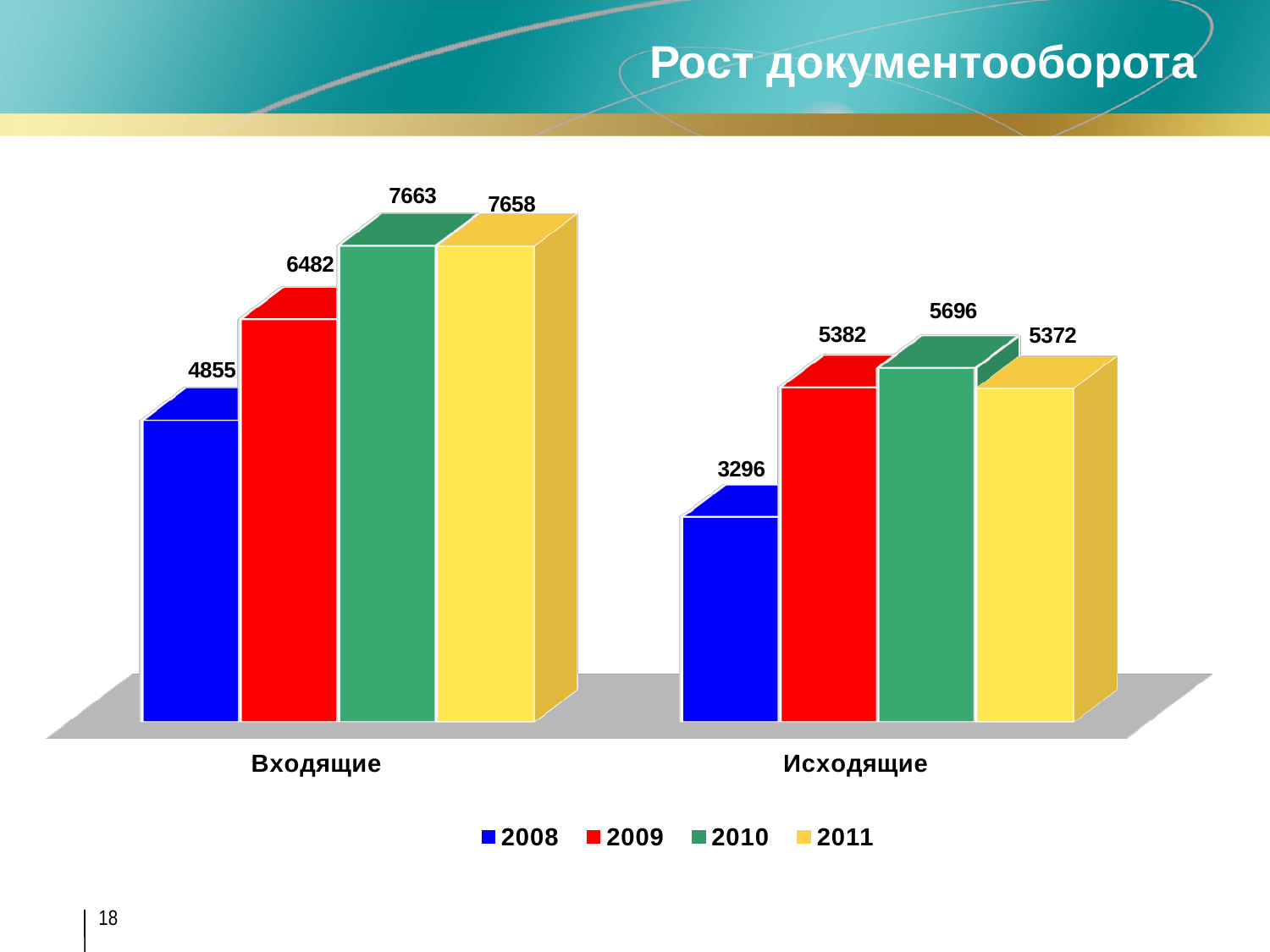
What is the title of the slide? Рост документооборота What is the value for 2011 in the Входящие category? 7658 What is the value for 2010 in the Исходящие category? 5696 How many series does the legend list? 4 Which year has the highest value in the Входящие category? 2010 How many categories are shown on the x axis? 2 What is the difference between the 2010 and 2011 values in the Исходящие category? 324 What is the value for 2008 in the Входящие category? 4855 Which year has the lowest value in the Исходящие category? 2008 What is the difference between the 2009 and 2008 values in the Входящие category? 1627 Which is larger: the 2009 value for Входящие or the 2009 value for Исходящие? Входящие What kind of chart is shown on the slide? Bar chart